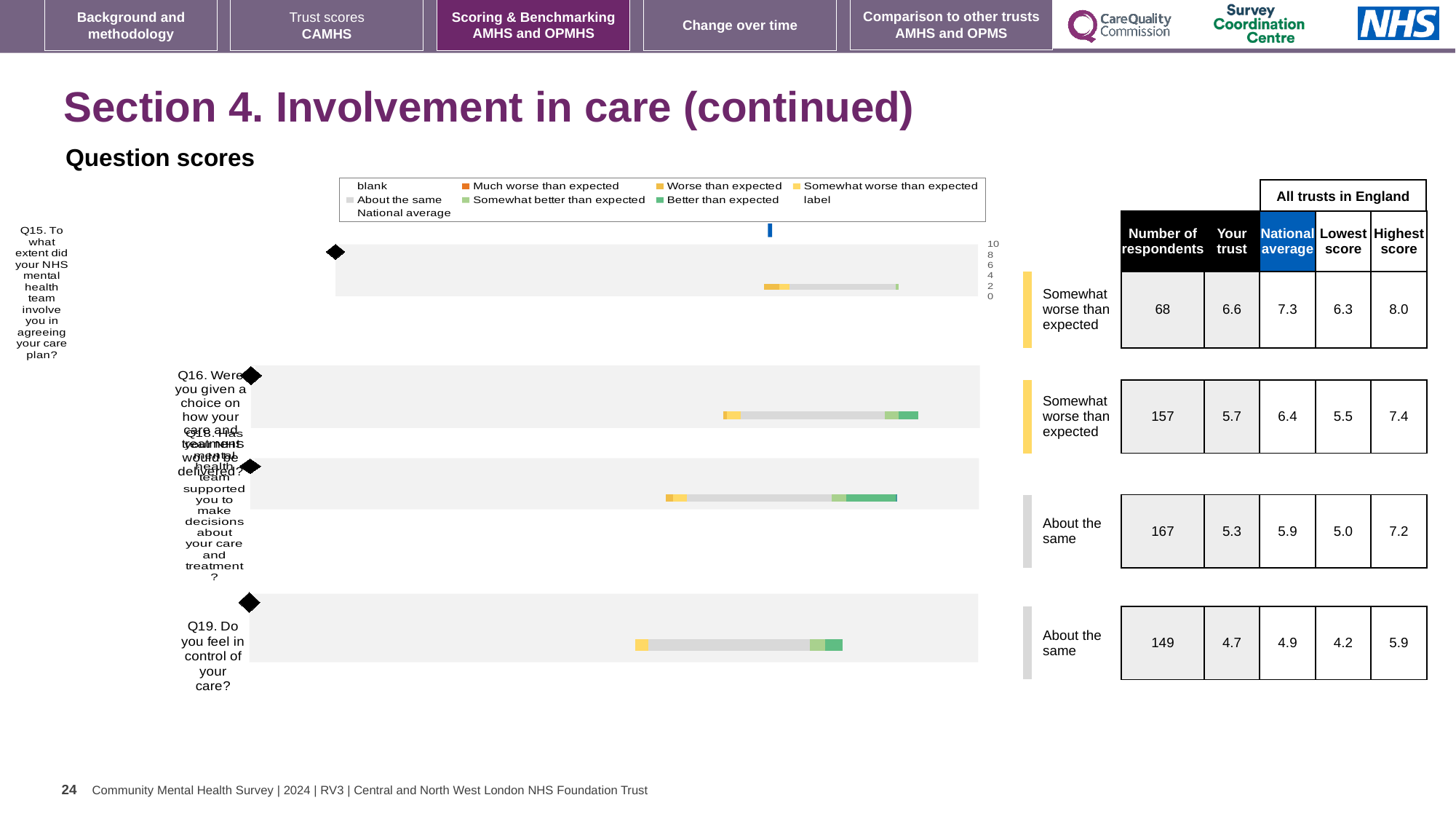
Which question has the largest number of respondents? Q18 How many respondents answered Q16 (choice on how care and treatment would be delivered)? 157 What is the difference between the national average and the 'Your trust' score for Q15? 0.7 What is the highest score among all trusts in England for Q18? 7.2 Which question has the smallest number of respondents? Q15 What benchmark category is shown for Q19? About the same What is the lowest score among all trusts in England for Q19 (feeling in control of your care)? 4.2 What is the national average score for Q15? 7.3 How many survey questions are plotted in the chart? 4 For Q16, which is larger: the 'Your trust' score or the national average? National average What kind of chart is shown on the slide? bar chart What is the 'Your trust' score for Q15 (involvement in agreeing your care plan)? 6.6